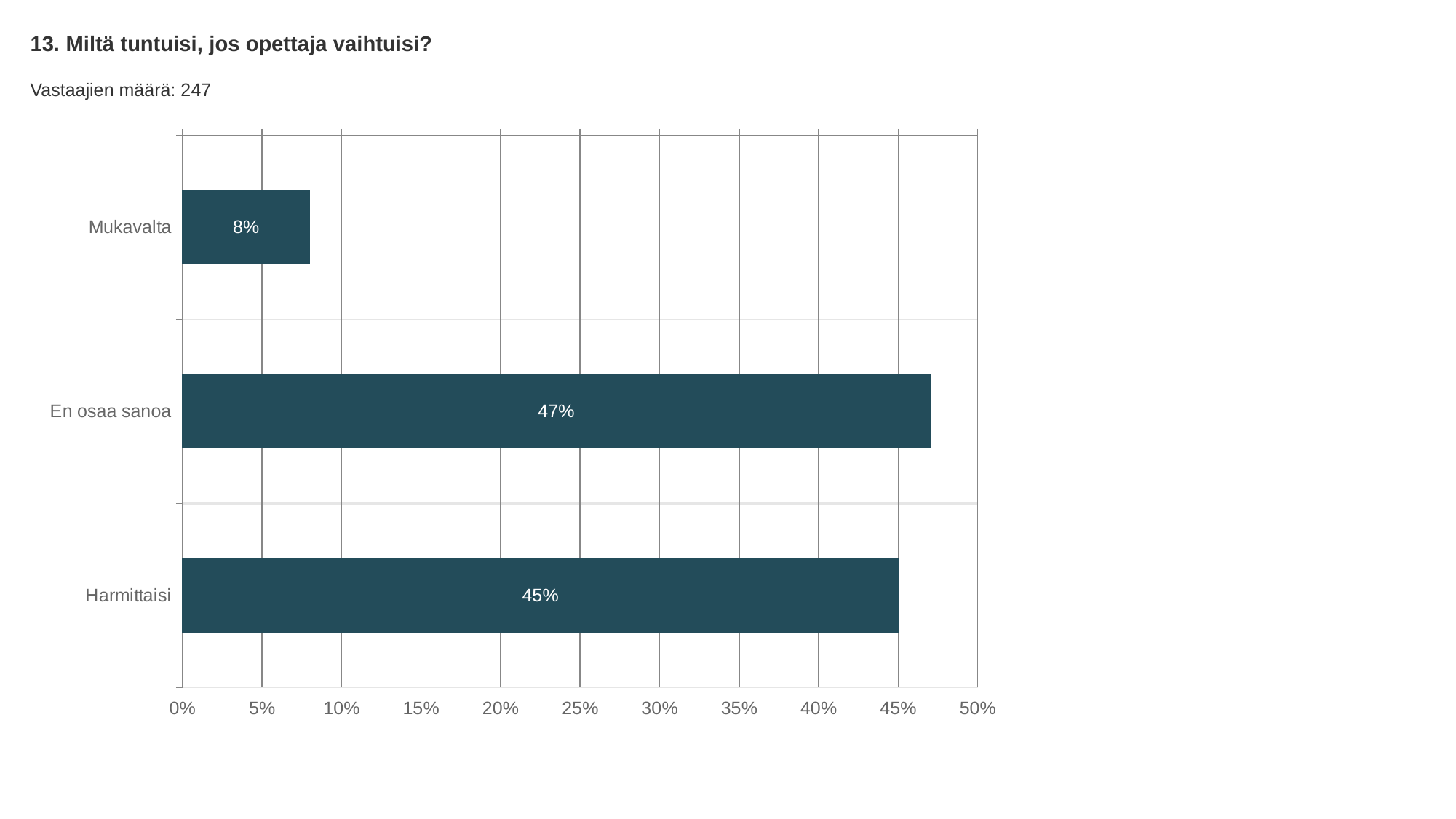
Which category has the lowest value? Mukavalta What is the difference between the values for En osaa sanoa and Harmittaisi? 2% What is the value for En osaa sanoa? 47% How many categories are shown in the chart? 3 What kind of chart is shown on the slide? bar chart What is the value for Mukavalta? 8% Which category has the highest value? En osaa sanoa Which is larger, the value for Harmittaisi or the value for Mukavalta? Harmittaisi Is the value for Mukavalta greater or less than 10%? less What is the value for Harmittaisi? 45% How many respondents (Vastaajien määrä) are reported on the slide? 247 What is the difference between the values for Harmittaisi and Mukavalta? 37%